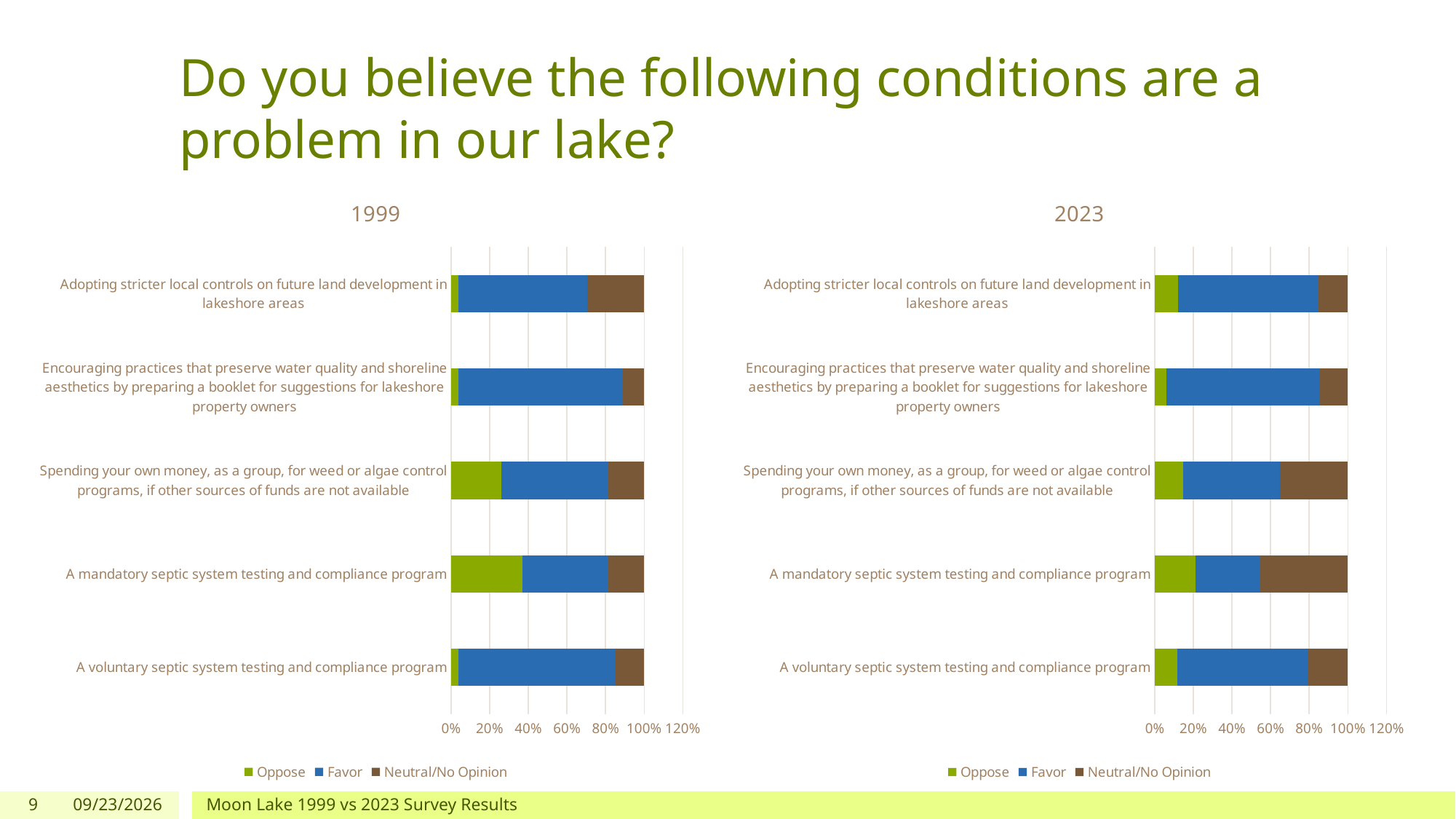
On the 2023 chart, which category has the largest Neutral/No Opinion segment? A mandatory septic system testing and compliance program On the 1999 chart, is the Oppose value for 'A mandatory septic system testing and compliance program' greater or less than 20%? greater On the 2023 chart, which category has the smallest Favor segment? A mandatory septic system testing and compliance program On the 1999 chart, is the Favor value for 'Encouraging practices that preserve water quality and shoreline aesthetics by preparing a booklet for suggestions for lakeshore property owners' greater or less than 80%? greater On the 2023 chart, which has the larger Neutral/No Opinion segment: 'Spending your own money, as a group, for weed or algae control programs, if other sources of funds are not available' or 'Adopting stricter local controls on future land development in lakeshore areas'? Spending your own money, as a group, for weed or algae control programs, if other sources of funds are not available Which chart shows a larger Oppose segment for 'A mandatory septic system testing and compliance program', the 1999 chart or the 2023 chart? 1999 How many categories are shown on the 2023 chart? 5 What are the legend entries on the 2023 chart? Oppose, Favor, Neutral/No Opinion What kind of chart is the 1999 chart? stacked bar chart On the 2023 chart, is the Favor value for 'A mandatory septic system testing and compliance program' greater or less than 40%? less On the 1999 chart, which category has the largest Oppose segment? A mandatory septic system testing and compliance program How many series does the legend of the 1999 chart list? 3